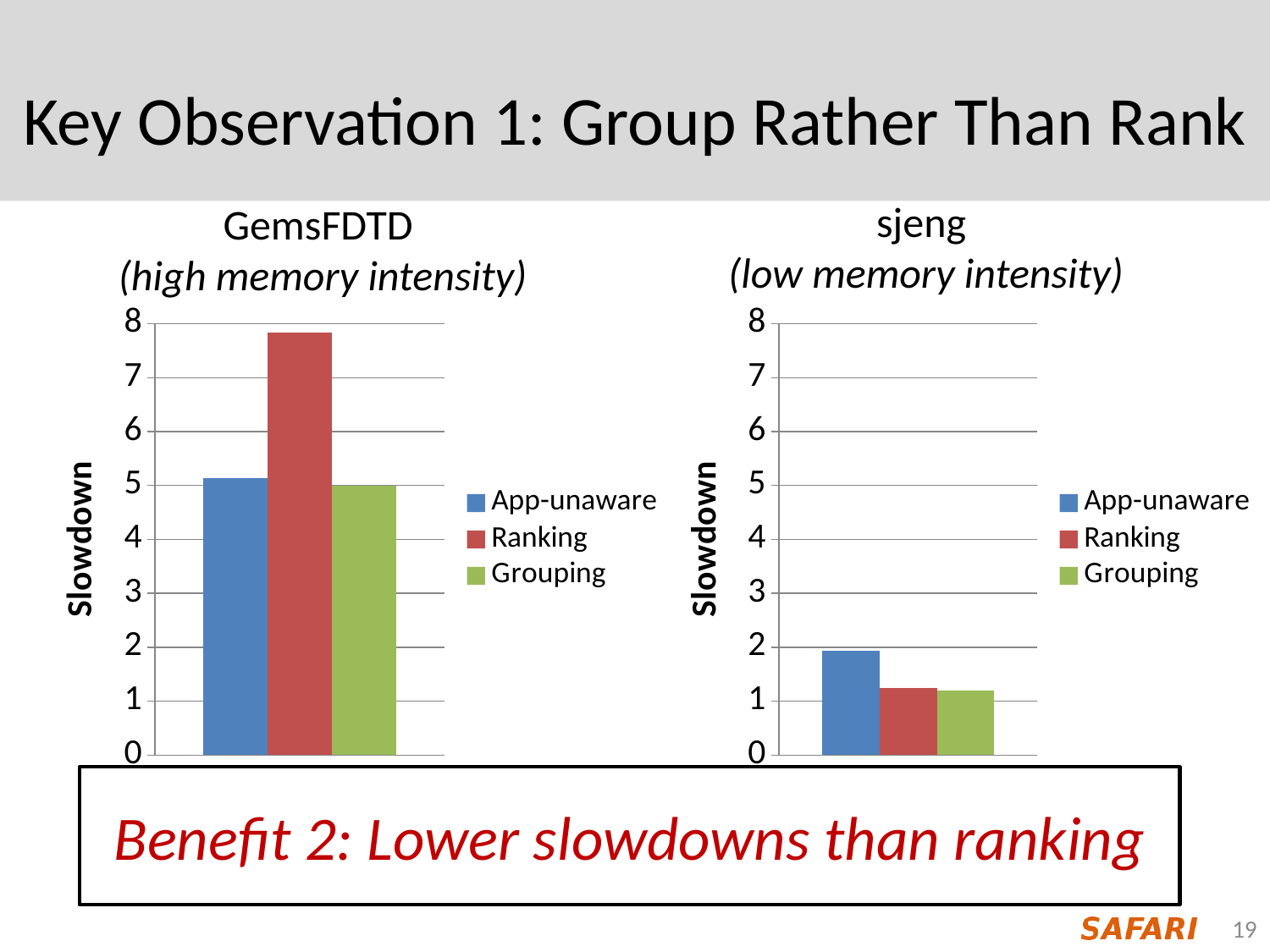
In the sjeng chart, which is larger, the slowdown for App-unaware or for Grouping? App-unaware In the GemsFDTD chart, is the slowdown for Ranking greater or less than 7? greater In the GemsFDTD chart, is the slowdown for App-unaware greater or less than 6? less What kind of chart is the GemsFDTD chart on the left? bar chart In the GemsFDTD chart, which series has the highest slowdown? Ranking In the GemsFDTD chart, which is larger, the slowdown for Ranking or for Grouping? Ranking How many series does the legend of the sjeng chart list? 3 In the sjeng chart, is the slowdown for Ranking greater or less than 1? greater Which colour represents Grouping in the legend of the GemsFDTD chart? green What is the label on the vertical axis of the sjeng chart? Slowdown In the sjeng chart, which series has the highest slowdown? App-unaware